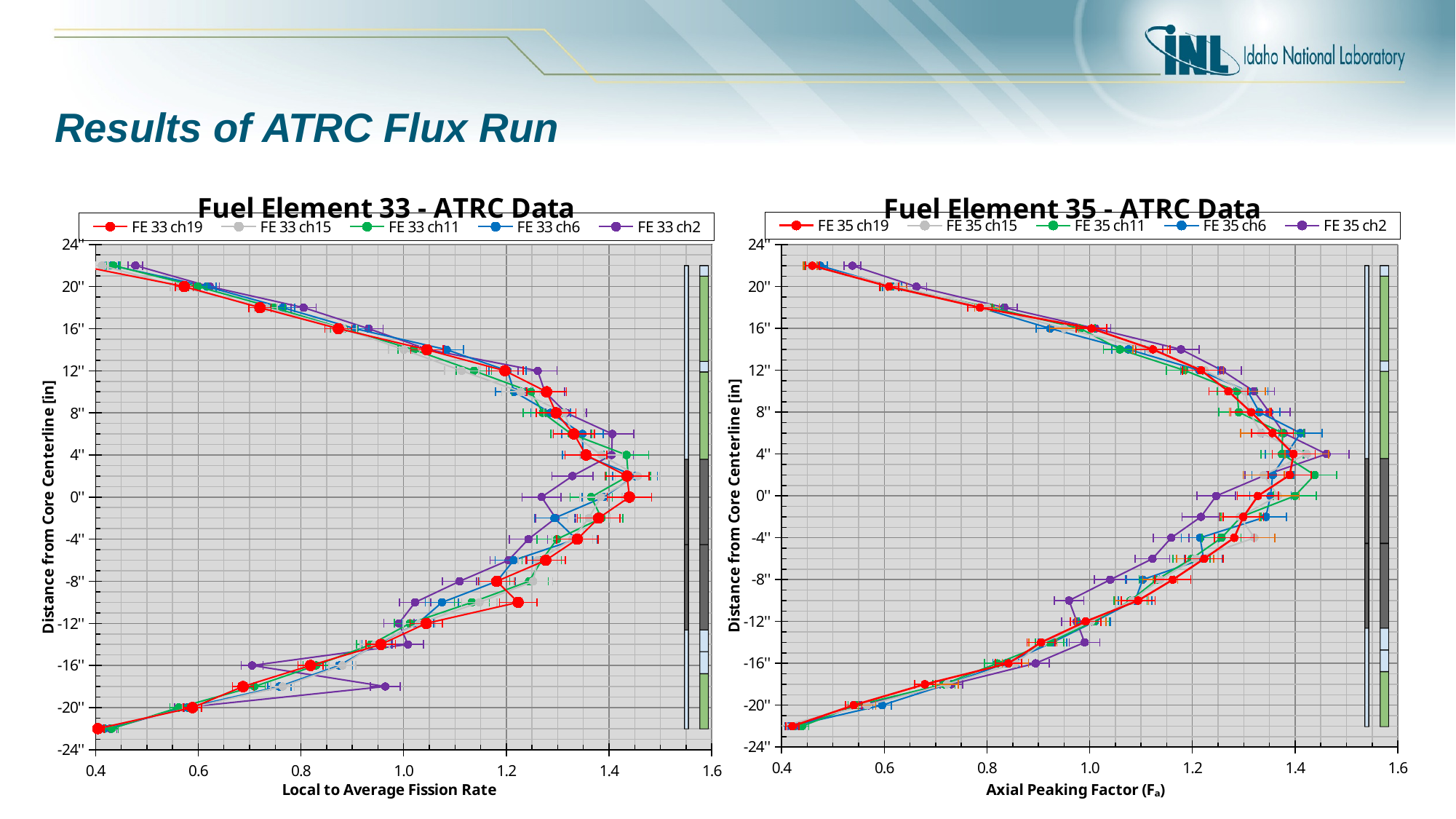
In the "Fuel Element 35 - ATRC Data" chart, is the FE 35 ch19 value at -22" greater or less than 0.6? less In the "Fuel Element 33 - ATRC Data" chart, which is larger at -18": the FE 33 ch2 value or the FE 33 ch19 value? FE 33 ch2 What is the x-axis label of the "Fuel Element 33 - ATRC Data" chart? Local to Average Fission Rate In the "Fuel Element 35 - ATRC Data" chart, does the FE 35 ch19 value rise or fall as the distance from core centerline goes from 4" to 22"? fall How many series does the legend of the "Fuel Element 35 - ATRC Data" chart list? 5 In the "Fuel Element 33 - ATRC Data" chart, is the FE 33 ch19 value at 22" greater or less than 0.6? less In the "Fuel Element 33 - ATRC Data" chart, does the FE 33 ch19 value rise or fall as the distance from core centerline goes from -22" to 0"? rise What is the x-axis label of the "Fuel Element 35 - ATRC Data" chart? Axial Peaking Factor (Fa) What kind of chart is the "Fuel Element 33 - ATRC Data" chart? line chart In the "Fuel Element 33 - ATRC Data" chart, is the FE 33 ch19 value at 0" greater or less than 1.2? greater In the "Fuel Element 35 - ATRC Data" chart, which series has the highest value at 4"? FE 35 ch2